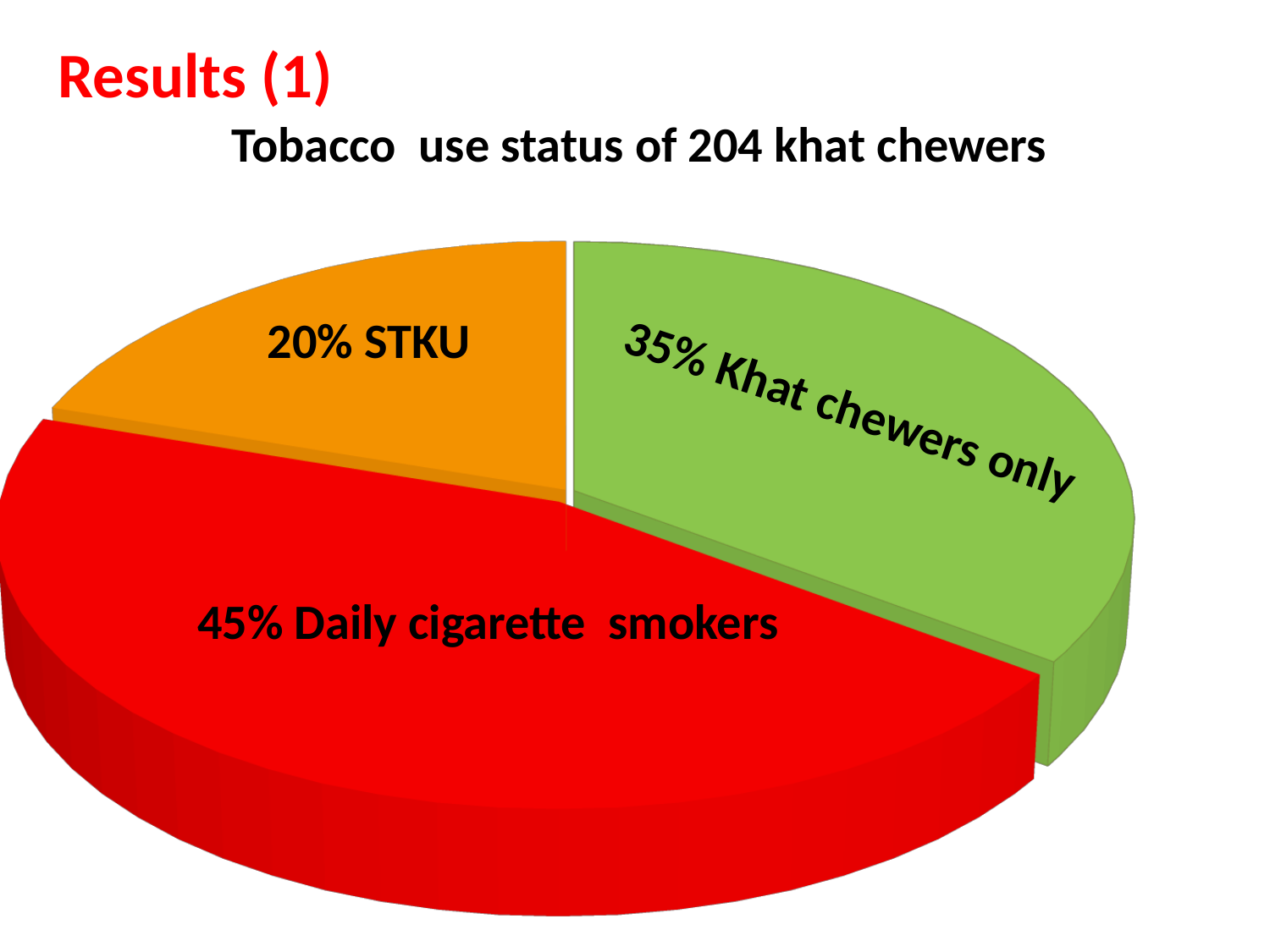
What percentage of khat chewers are khat chewers only? 35% What is the difference in percentage points between daily cigarette smokers and STKU? 25 What colour is the slice for daily cigarette smokers? Red What percentage of khat chewers are daily cigarette smokers? 45% What type of chart is shown on the slide? Pie chart What percentage of khat chewers are STKU? 20% Which category has the smallest share of the pie? STKU How many slices does the pie chart have? 3 What is the difference in percentage points between daily cigarette smokers and khat chewers only? 10 Which category has the largest share of the pie? Daily cigarette smokers What is the title of the chart? Tobacco use status of 204 khat chewers Which is larger, the share for khat chewers only or the share for STKU? Khat chewers only